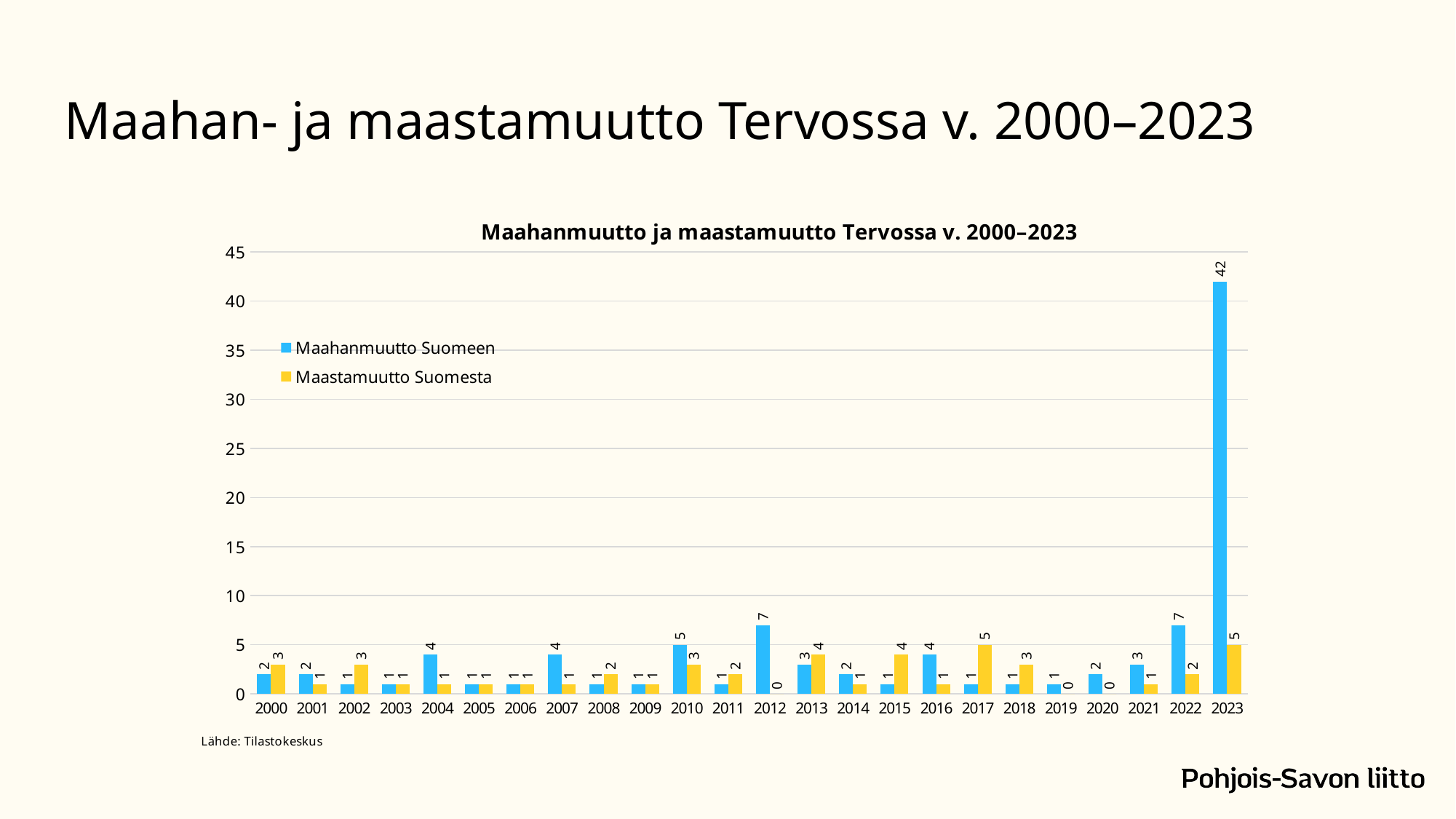
What is the value of Maastamuutto Suomesta in 2020? 0 What is the title of the chart? Maahanmuutto ja maastamuutto Tervossa v. 2000–2023 What is the value of Maahanmuutto Suomeen in 2023? 42 What is the value of Maahanmuutto Suomeen in 2012? 7 Which is larger in 2015, Maahanmuutto Suomeen or Maastamuutto Suomesta? Maastamuutto Suomesta What is the difference between Maahanmuutto Suomeen and Maastamuutto Suomesta in 2023? 37 How many series does the legend list? 2 What kind of chart is shown on the slide? Bar chart How many years are shown on the x axis? 24 In which year is Maahanmuutto Suomeen highest? 2023 What is the value of Maastamuutto Suomesta in 2017? 5 Is the value of Maahanmuutto Suomeen in 2023 greater or less than 40? greater